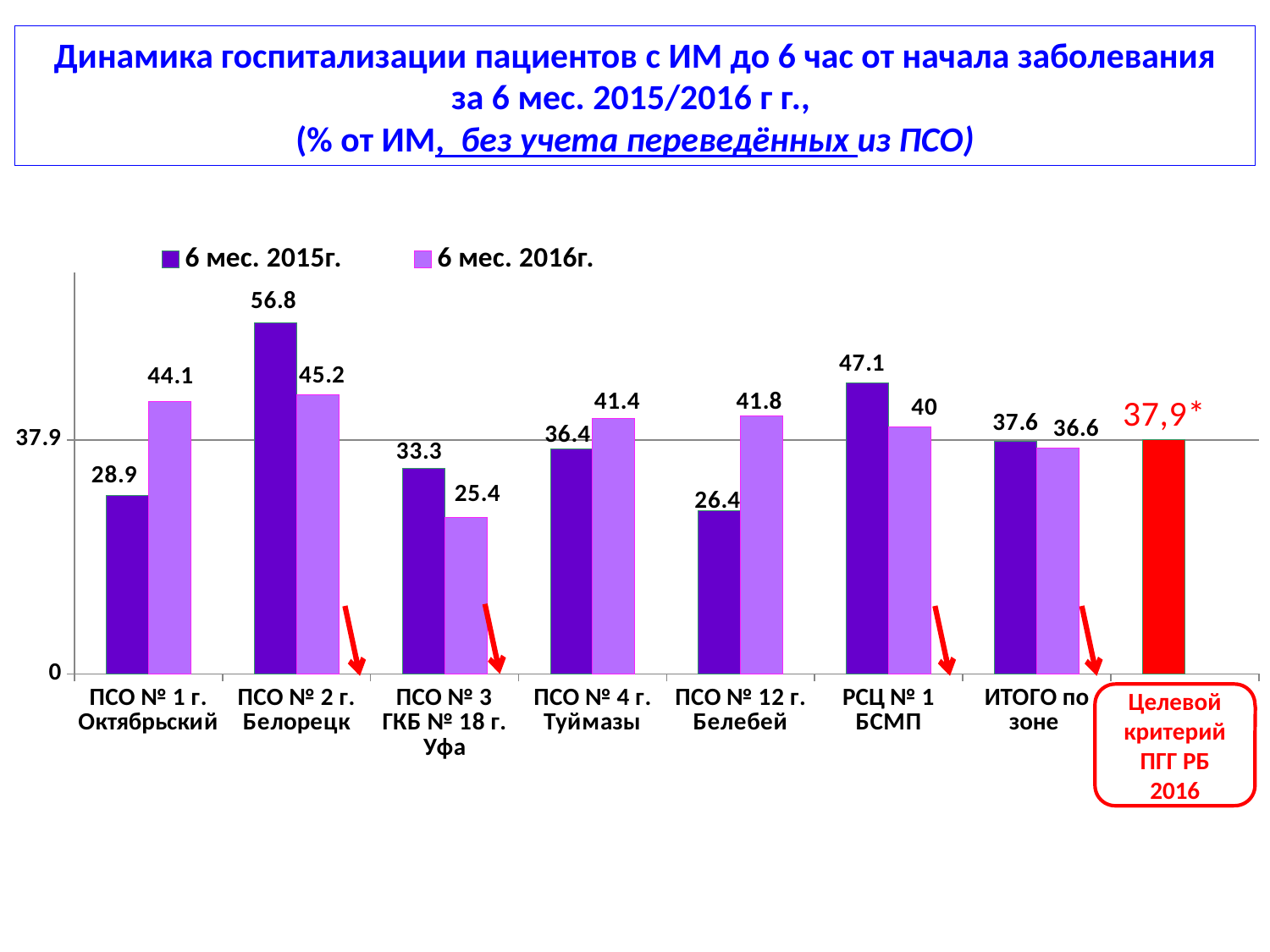
What is the value for ИТОГО по зоне in the 6 мес. 2016г. series? 36.6 Is the 6 мес. 2015г. value for ПСО № 12 г. Белебей greater or less than 37.9? less What is the value for ПСО № 12 г. Белебей in the 6 мес. 2016г. series? 41.8 What value is shown for the red bar labelled Целевой критерий ПГГ РБ 2016? 37,9* What kind of chart is shown on the slide? bar chart What is the difference between the 6 мес. 2015г. and 6 мес. 2016г. values for ПСО № 1 г. Октябрьский? 15.2 Which category has the lowest value in the 6 мес. 2016г. series? ПСО № 3 ГКБ № 18 г. Уфа Which is larger for ПСО № 3 ГКБ № 18 г. Уфа: the 6 мес. 2015г. value or the 6 мес. 2016г. value? 6 мес. 2015г. What is the value for ПСО № 2 г. Белорецк in the 6 мес. 2015г. series? 56.8 What is the value for РСЦ № 1 БСМП in the 6 мес. 2016г. series? 40 Which category has the highest value in the 6 мес. 2015г. series? ПСО № 2 г. Белорецк How many series does the legend list? 2